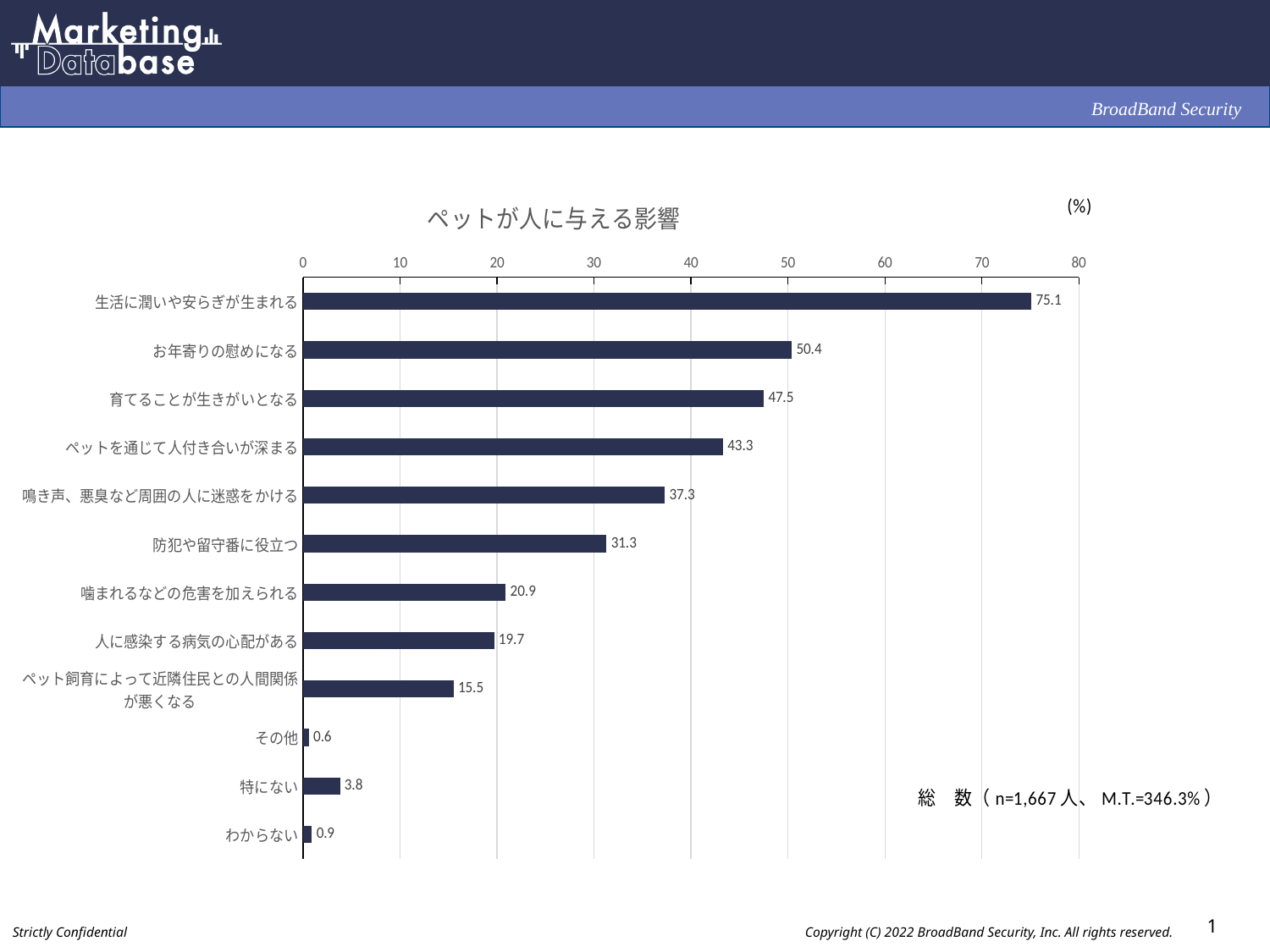
How many categories are shown in the chart? 12 What is the value for 生活に潤いや安らぎが生まれる? 75.1 What is the sample size (n) shown on the slide? 1,667人 What is the value for ペット飼育によって近隣住民との人間関係が悪くなる? 15.5 Which is larger, the value for 噛まれるなどの危害を加えられる or 人に感染する病気の心配がある? 噛まれるなどの危害を加えられる What is the difference between the values for お年寄りの慰めになる and 育てることが生きがいとなる? 2.9 What is the title of the chart? ペットが人に与える影響 What kind of chart is shown on the slide? bar chart Is the value for 鳴き声、悪臭など周囲の人に迷惑をかける greater or less than 40? less Which category has the lowest value? その他 What is the value for 防犯や留守番に役立つ? 31.3 Which category has the highest value? 生活に潤いや安らぎが生まれる